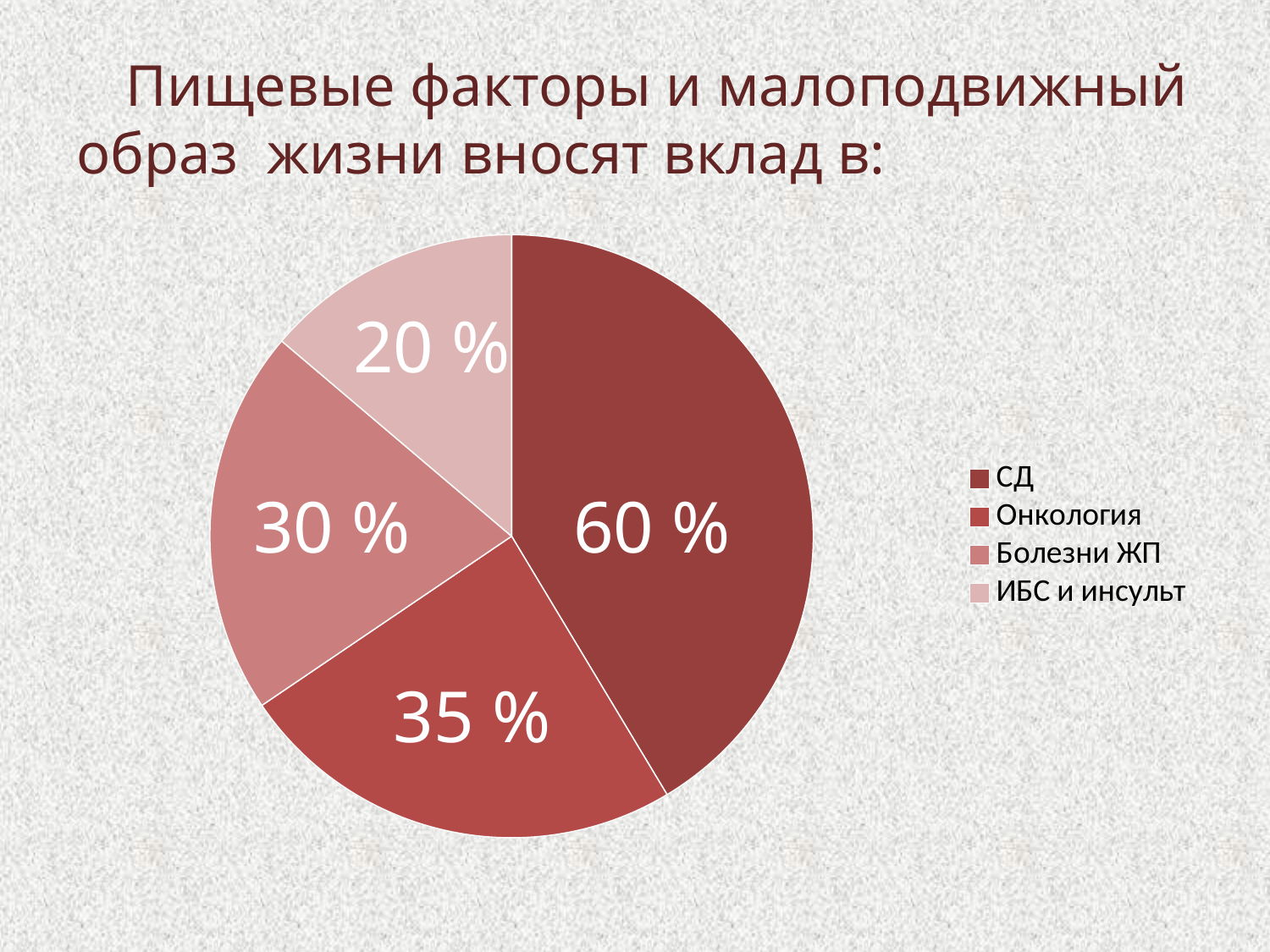
What value is shown for the СД slice? 60 % Which legend entry is shown with the lightest colour? ИБС и инсульт What kind of chart is shown on the slide? Pie chart What is the difference between the values for СД and Онкология? 25 % What value is shown for the Онкология slice? 35 % How many categories does the pie chart show? 4 Which category has the largest slice of the pie? СД Which category has the smallest slice of the pie? ИБС и инсульт What value is shown for the ИБС и инсульт slice? 20 % What is the difference between the values for Болезни ЖП and ИБС и инсульт? 10 % Which is larger, the value for Онкология or the value for Болезни ЖП? Онкология What value is shown for the Болезни ЖП slice? 30 %